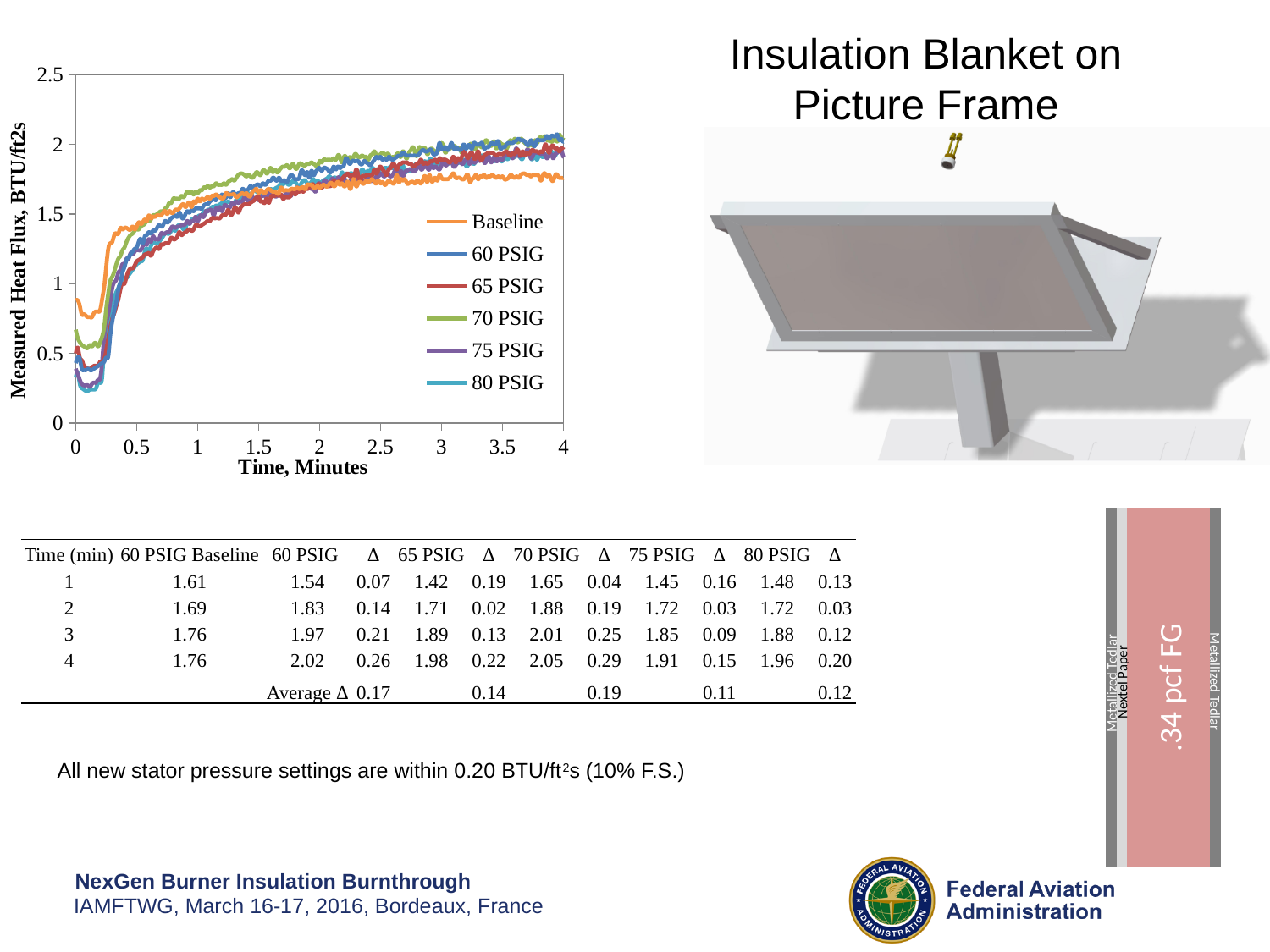
In the heat flux chart, do the values generally rise or fall as time increases from 0 to 4 minutes? rise In the heat flux chart, is the 60 PSIG value at 3 minutes greater or less than 1.5? greater What kind of chart is shown on the left of the slide? line chart In the heat flux chart, is the Baseline value at 4 minutes greater or less than 2? less In the heat flux chart, is the 80 PSIG value at about 0.1 minutes greater or less than 0.5? less In the heat flux chart, at 4 minutes, which is higher: 70 PSIG or Baseline? 70 PSIG In the heat flux chart, which series has the lowest value at 4 minutes? Baseline What is the title of the x axis of the heat flux chart? Time, Minutes How many series does the legend of the heat flux chart list? 6 In the heat flux chart, at 0.5 minutes, which is higher: Baseline or 65 PSIG? Baseline What is the title of the y axis of the heat flux chart? Measured Heat Flux, BTU/ft2s